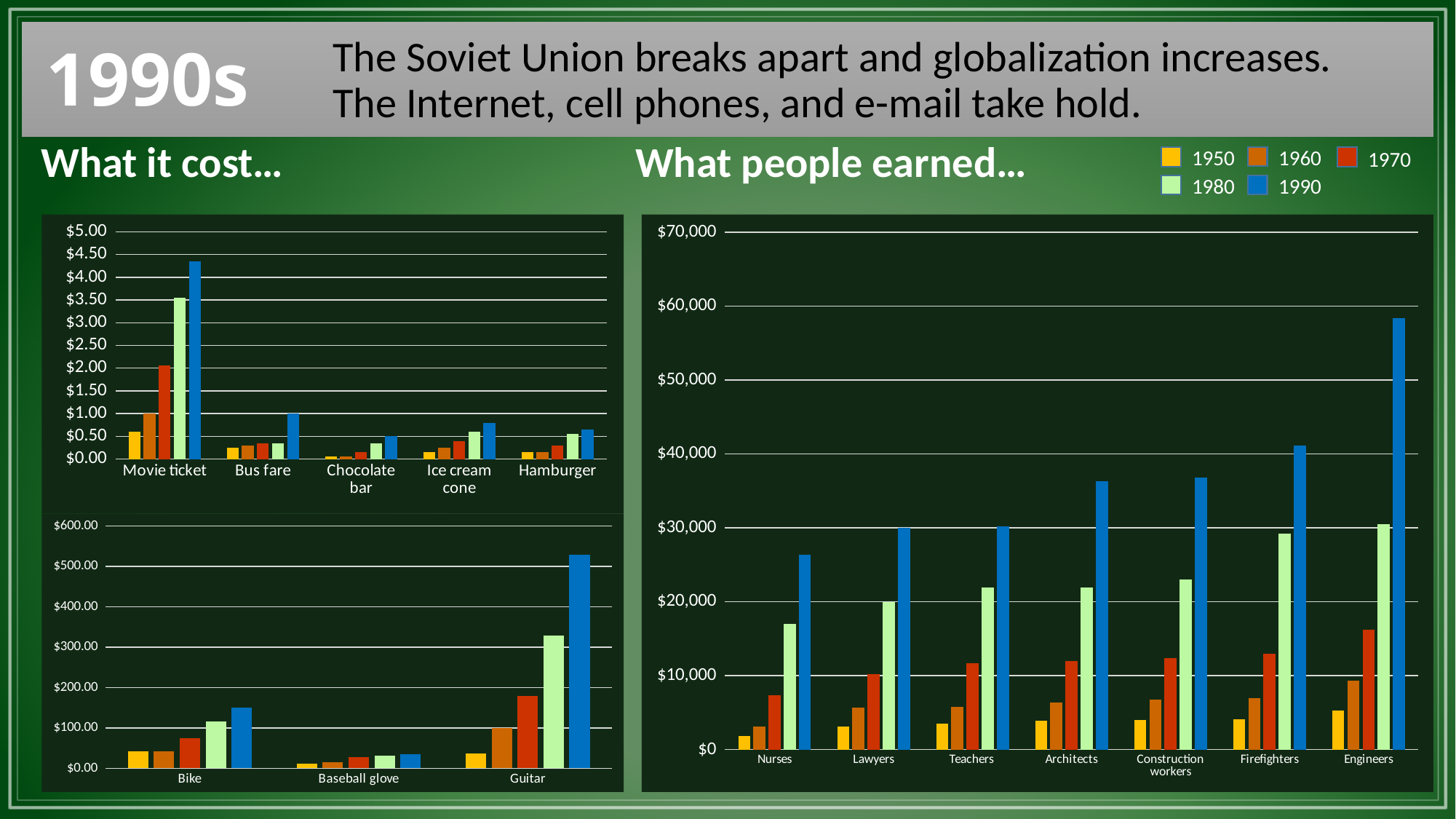
What kind of chart is the 'What people earned...' chart? bar chart On the 'What people earned...' chart, is the 1990 value for Nurses greater or less than $30,000? less On the top-left 'What it cost...' chart, which item has the highest 1990 price? Movie ticket On the 'What people earned...' chart, which is larger: the 1990 value for Firefighters or the 1990 value for Architects? Firefighters On the bottom-left 'What it cost...' chart, is the 1990 value for Guitar greater or less than $500.00? greater How many occupations are shown on the 'What people earned...' chart? 7 On the 'What people earned...' chart, which occupation has the lowest 1990 earnings? Nurses On the 'What people earned...' chart, do the values for Engineers rise or fall from 1950 to 1990? rise On the 'What people earned...' chart, which occupation has the highest 1990 earnings? Engineers On the 'What people earned...' chart, is the 1990 value for Engineers greater or less than $50,000? greater How many series does the legend list? 5